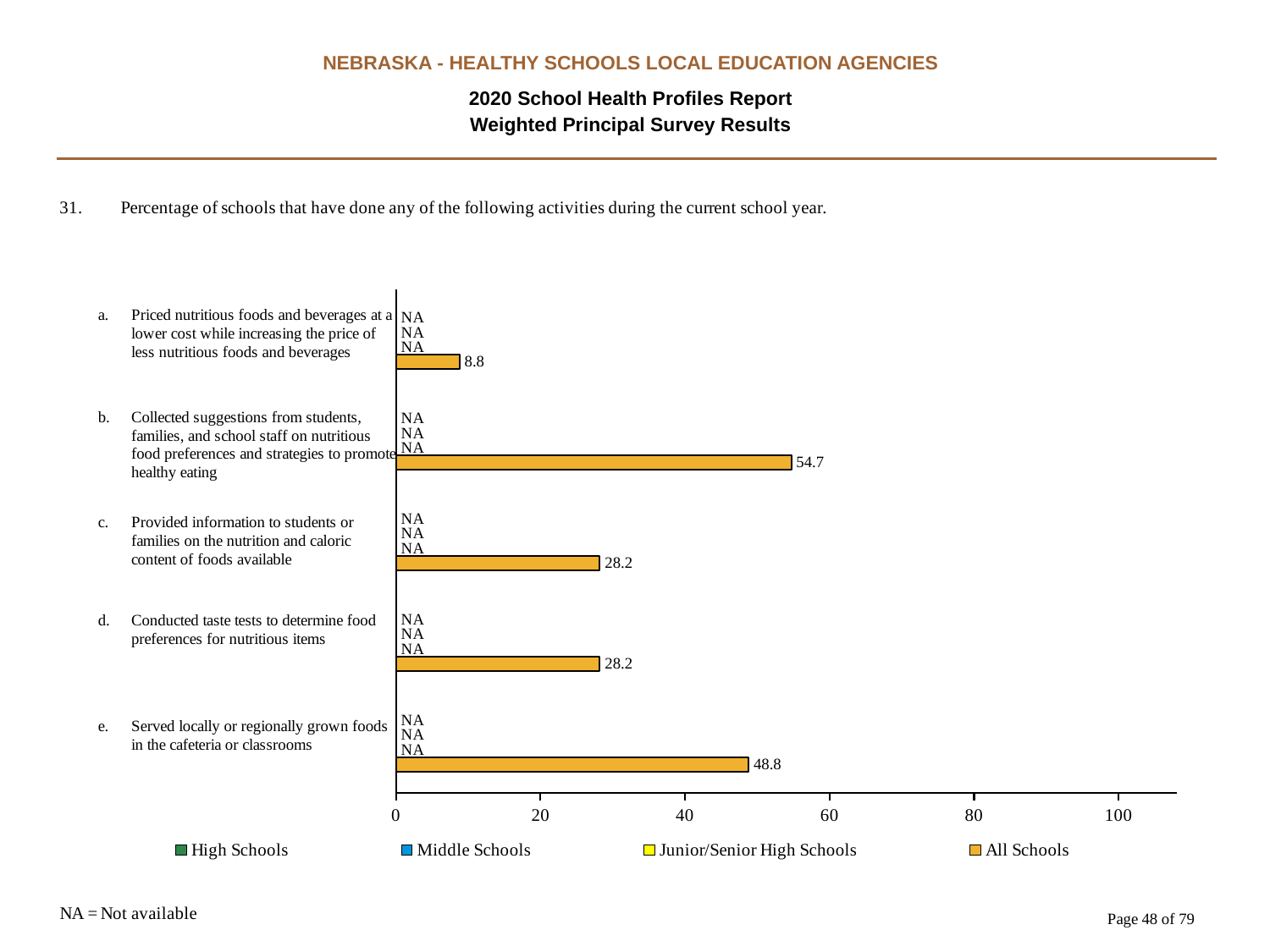
What is the All Schools value for activity b, collected suggestions from students, families, and school staff on nutritious food preferences and strategies to promote healthy eating? 54.7 What is the All Schools value for activity e, served locally or regionally grown foods in the cafeteria or classrooms? 48.8 How many series does the legend list? 4 Which activity has the lowest All Schools percentage? a. Priced nutritious foods and beverages at a lower cost while increasing the price of less nutritious foods and beverages What kind of chart is shown on the slide? Bar chart What is the difference between the All Schools values for activity b and activity e? 5.9 Which is larger for All Schools: the value for activity e (served locally or regionally grown foods) or activity c (provided information on nutrition and caloric content)? Activity e (served locally or regionally grown foods) How many activities (categories) are shown in the chart? 5 What is the All Schools value for activity a, priced nutritious foods and beverages at a lower cost while increasing the price of less nutritious foods and beverages? 8.8 What value is shown for High Schools for activity d, conducted taste tests to determine food preferences for nutritious items? NA What is the All Schools value for activity c, provided information to students or families on the nutrition and caloric content of foods available? 28.2 Which activity has the highest All Schools percentage? b. Collected suggestions from students, families, and school staff on nutritious food preferences and strategies to promote healthy eating